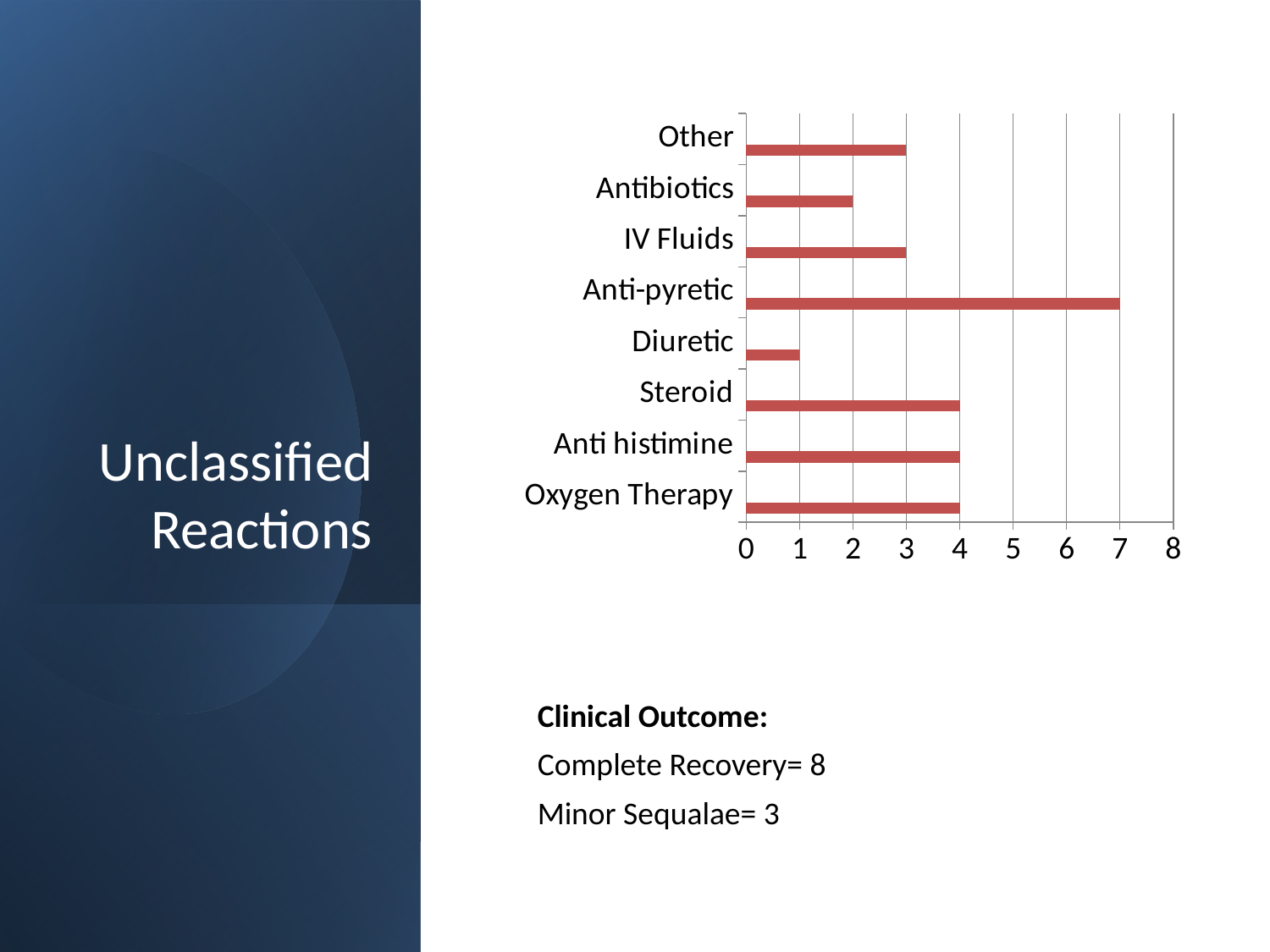
What is the value for Steroid? 4 Which category has the highest value in the bar chart? Anti-pyretic How many categories are plotted in the bar chart? 8 What is the value for Antibiotics? 2 Which category has the lowest value in the bar chart? Diuretic What is the maximum value shown on the horizontal axis of the chart? 8 What is the difference between the values for Anti-pyretic and IV Fluids? 4 What is the value for Anti-pyretic? 7 Which is larger, the value for Other or the value for Antibiotics? Other Is the value for Oxygen Therapy greater or less than 2? greater What kind of chart is shown on the slide? Bar chart What is the value for Diuretic? 1